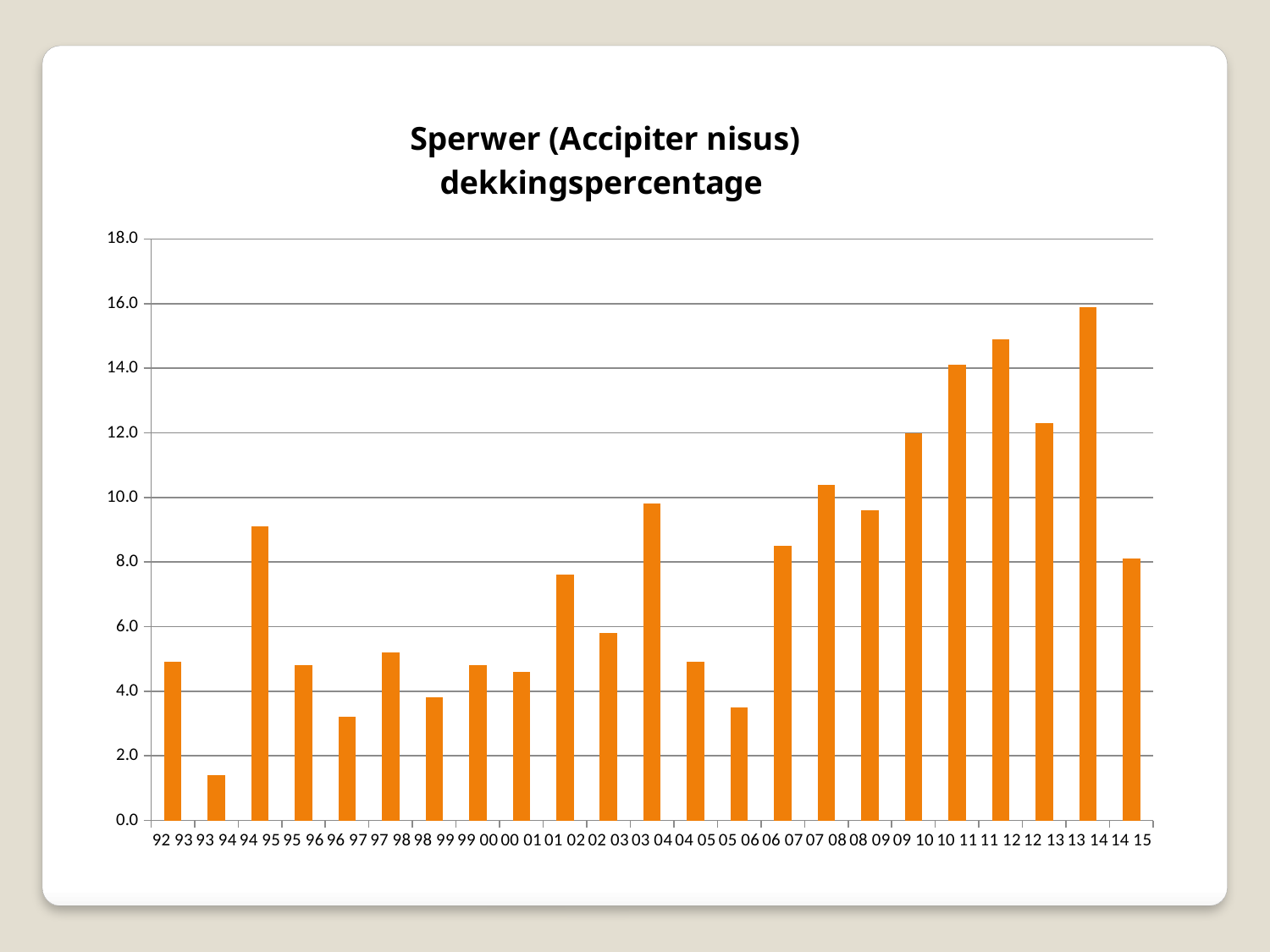
What kind of chart is shown on the slide? bar chart Is the value for 11 12 greater or less than 14.0? greater Is the value for 96 97 greater or less than 4.0? less Is the value for 13 14 greater or less than 14.0? greater How many bars (seasons) are plotted in the chart? 23 Which season has the larger value, 94 95 or 01 02? 94 95 What is the title of the chart? Sperwer (Accipiter nisus) dekkingspercentage Which season has the highest dekkingspercentage? 13 14 Which season has the lowest dekkingspercentage? 93 94 Which season has the larger value, 12 13 or 11 12? 11 12